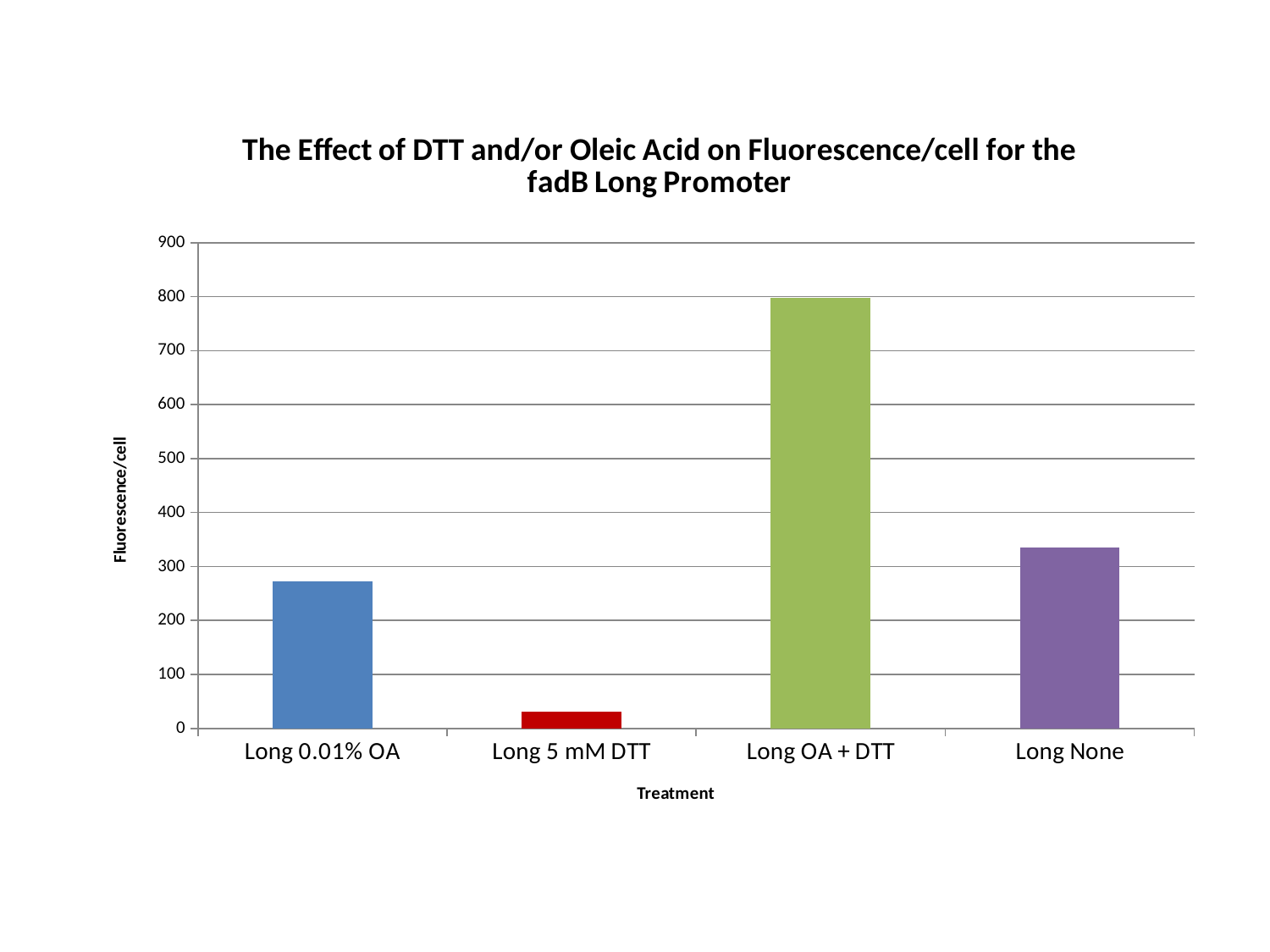
What is the title of the chart? The Effect of DTT and/or Oleic Acid on Fluorescence/cell for the fadB Long Promoter How many treatment categories are plotted on the chart? 4 Which treatment has the highest fluorescence/cell? Long OA + DTT Which treatment has the lowest fluorescence/cell? Long 5 mM DTT Which has a larger fluorescence/cell, Long None or Long 0.01% OA? Long None Is the value for Long 0.01% OA greater or less than 300? less Is the value for Long None greater or less than 300? greater What is the label of the x axis? Treatment Which has a larger fluorescence/cell, Long 5 mM DTT or Long OA + DTT? Long OA + DTT Is the value for Long 5 mM DTT greater or less than 100? less What kind of chart is shown on the slide? bar chart